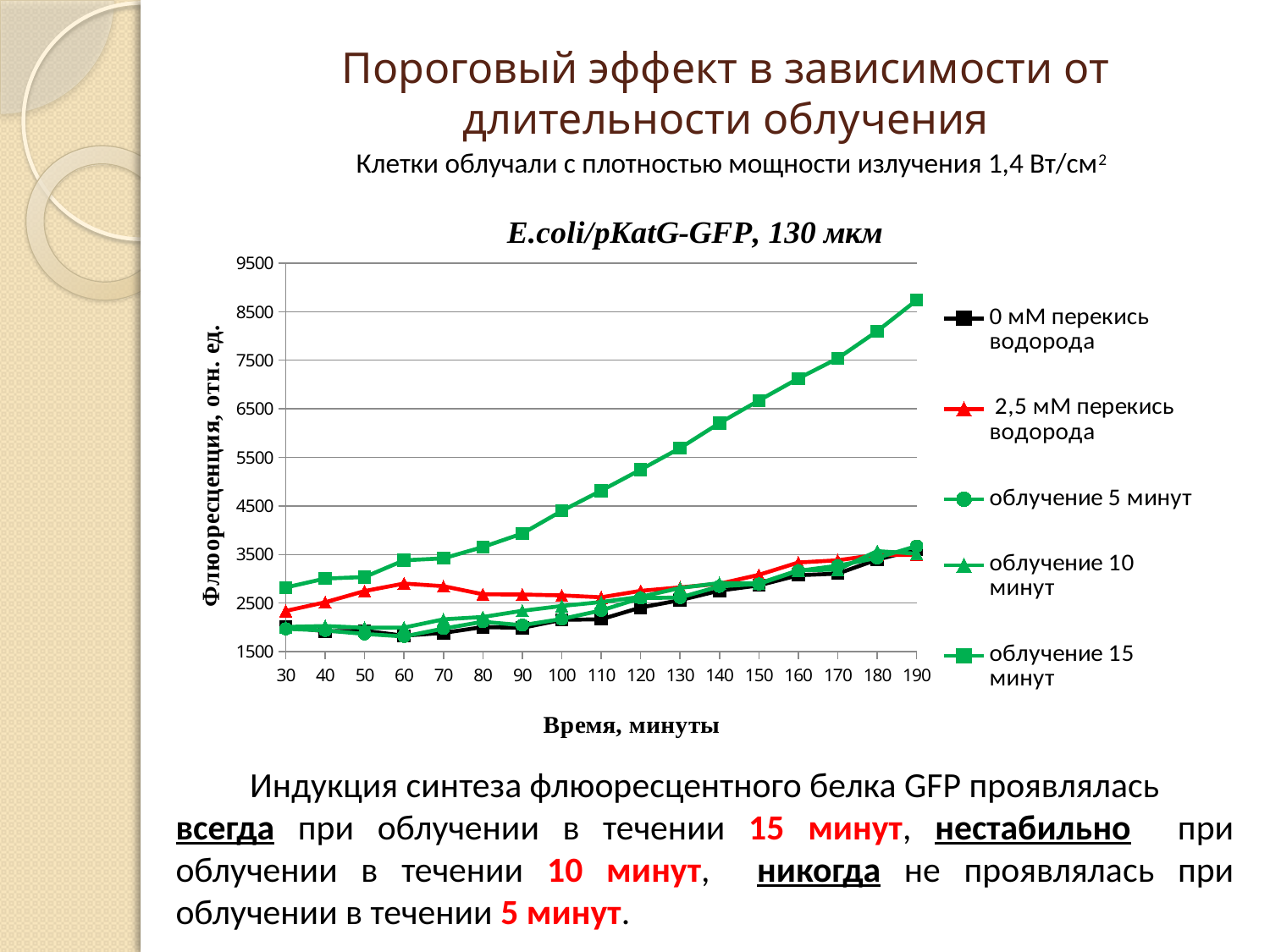
Is the value for 2,5 мМ перекись водорода at 60 minutes greater or less than 2500? greater How many series does the legend list? 5 Which series has the highest value at 190 minutes? облучение 15 минут Is the value for облучение 15 минут at 110 minutes greater or less than 5500? less Is the value for облучение 15 минут at 190 minutes greater or less than 8500? greater Does the облучение 15 минут series rise or fall as time increases along the x axis? rise What kind of chart is shown on the slide? line chart What is the title of the chart? E.coli/pKatG-GFP, 130 мкм How many time points are plotted along the x axis? 17 At 60 minutes, which is larger: the value for 2,5 мМ перекись водорода or for 0 мМ перекись водорода? 2,5 мМ перекись водорода